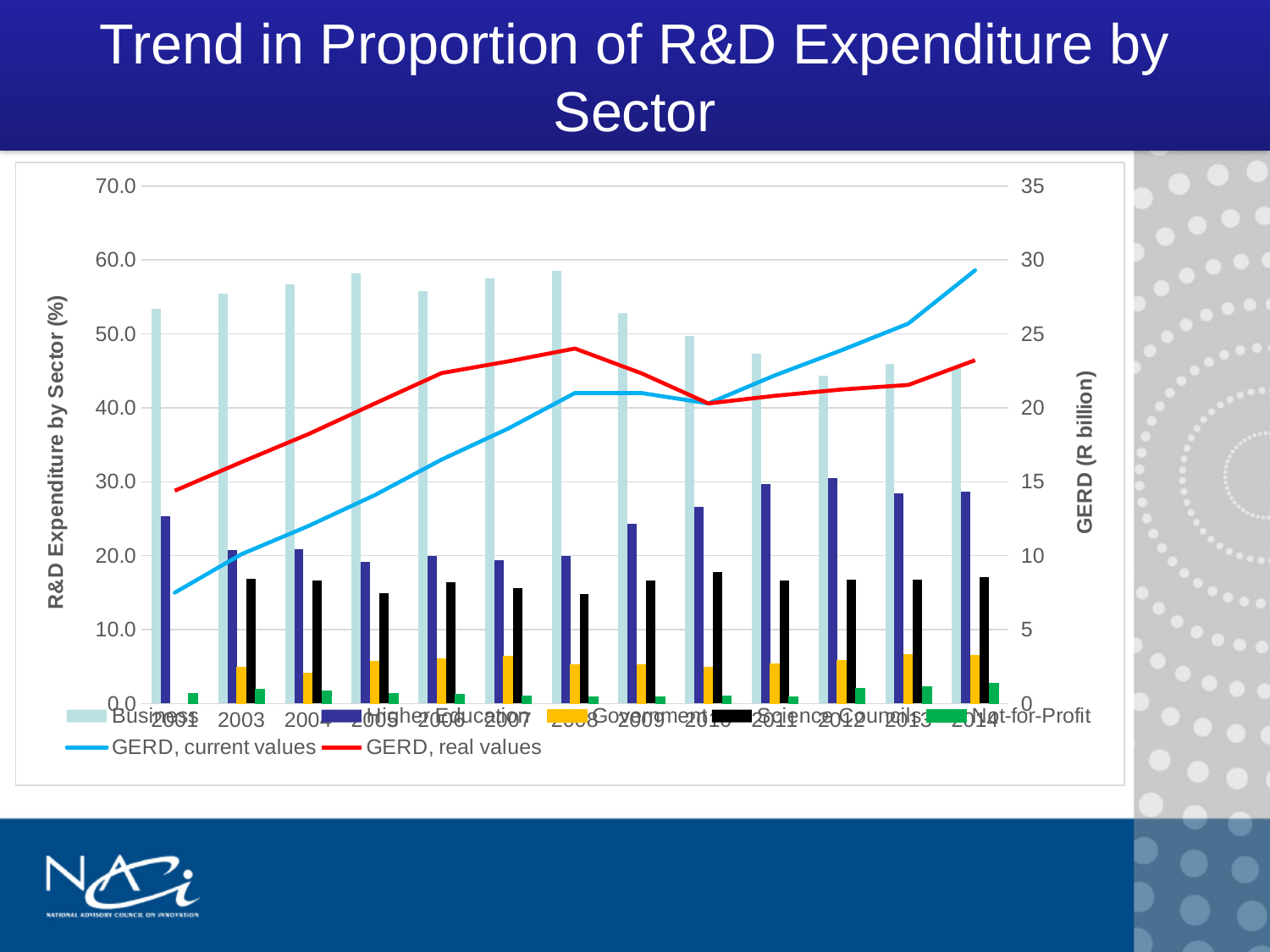
Which is larger in 2014, the Government bar or the Science Councils bar? Science Councils Do the Business bars rise or fall from 2008 to 2012? Fall Is the GERD, current values figure for 2014 greater or less than 25 on the right axis? greater Is the Business value for 2001 greater or less than 50? greater Does the GERD, current values line rise or fall from 2001 to 2014? Rises Which is larger in 2001, the Business bar or the Higher Education bar? Business What kind of chart is shown on the slide? A combination bar and line chart How many years are shown along the x axis? 13 Is the Business value for 2012 greater or less than 50? less How many series does the legend list? 7 What is the label of the right-hand vertical axis? GERD (R billion)